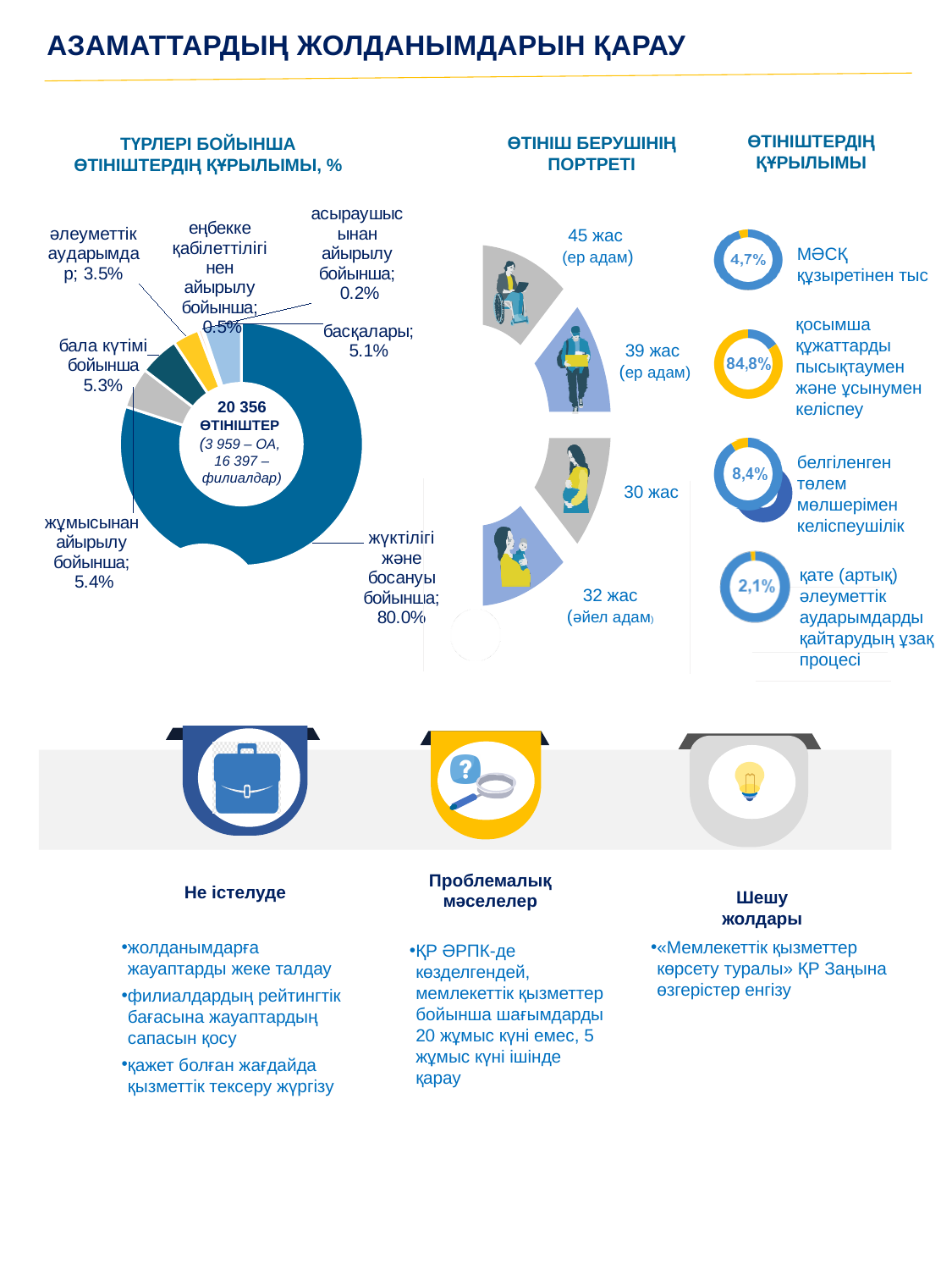
On the donut chart 'ТҮРЛЕРІ БОЙЫНША ӨТІНІШТЕРДІҢ ҚҰРЫЛЫМЫ, %', what is the difference between the shares for 'жұмысынан айырылу бойынша' and 'әлеуметтік аударымдар'? 1.9% How many categories are shown on the donut chart 'ТҮРЛЕРІ БОЙЫНША ӨТІНІШТЕРДІҢ ҚҰРЫЛЫМЫ, %'? 7 On the donut chart 'ТҮРЛЕРІ БОЙЫНША ӨТІНІШТЕРДІҢ ҚҰРЫЛЫМЫ, %', which category has the largest share? жүктілігі және босануы бойынша In the 'ӨТІНІШТЕРДІҢ ҚҰРЫЛЫМЫ' section on the right, what percentage is shown for 'қосымша құжаттарды пысықтаумен және ұсынумен келіспеу'? 84,8% In the 'ӨТІНІШТЕРДІҢ ҚҰРЫЛЫМЫ' section on the right, what percentage is shown for 'МӘСҚ құзыретінен тыс'? 4,7% On the donut chart 'ТҮРЛЕРІ БОЙЫНША ӨТІНІШТЕРДІҢ ҚҰРЫЛЫМЫ, %', which category has the smallest share? асыраушысынан айырылу бойынша On the donut chart 'ТҮРЛЕРІ БОЙЫНША ӨТІНІШТЕРДІҢ ҚҰРЫЛЫМЫ, %', which is larger: 'басқалары' or 'бала күтімі бойынша'? бала күтімі бойынша On the donut chart 'ТҮРЛЕРІ БОЙЫНША ӨТІНІШТЕРДІҢ ҚҰРЫЛЫМЫ, %', what share is labelled for 'жүктілігі және босануы бойынша'? 80.0% On the donut chart 'ТҮРЛЕРІ БОЙЫНША ӨТІНІШТЕРДІҢ ҚҰРЫЛЫМЫ, %', what share is labelled for 'асыраушысынан айырылу бойынша'? 0.2% What type of chart is 'ТҮРЛЕРІ БОЙЫНША ӨТІНІШТЕРДІҢ ҚҰРЫЛЫМЫ, %'? Donut (pie) chart On the donut chart 'ТҮРЛЕРІ БОЙЫНША ӨТІНІШТЕРДІҢ ҚҰРЫЛЫМЫ, %', what share is labelled for 'бала күтімі бойынша'? 5.3% What total number of applications is printed in the centre of the donut chart 'ТҮРЛЕРІ БОЙЫНША ӨТІНІШТЕРДІҢ ҚҰРЫЛЫМЫ, %'? 20 356